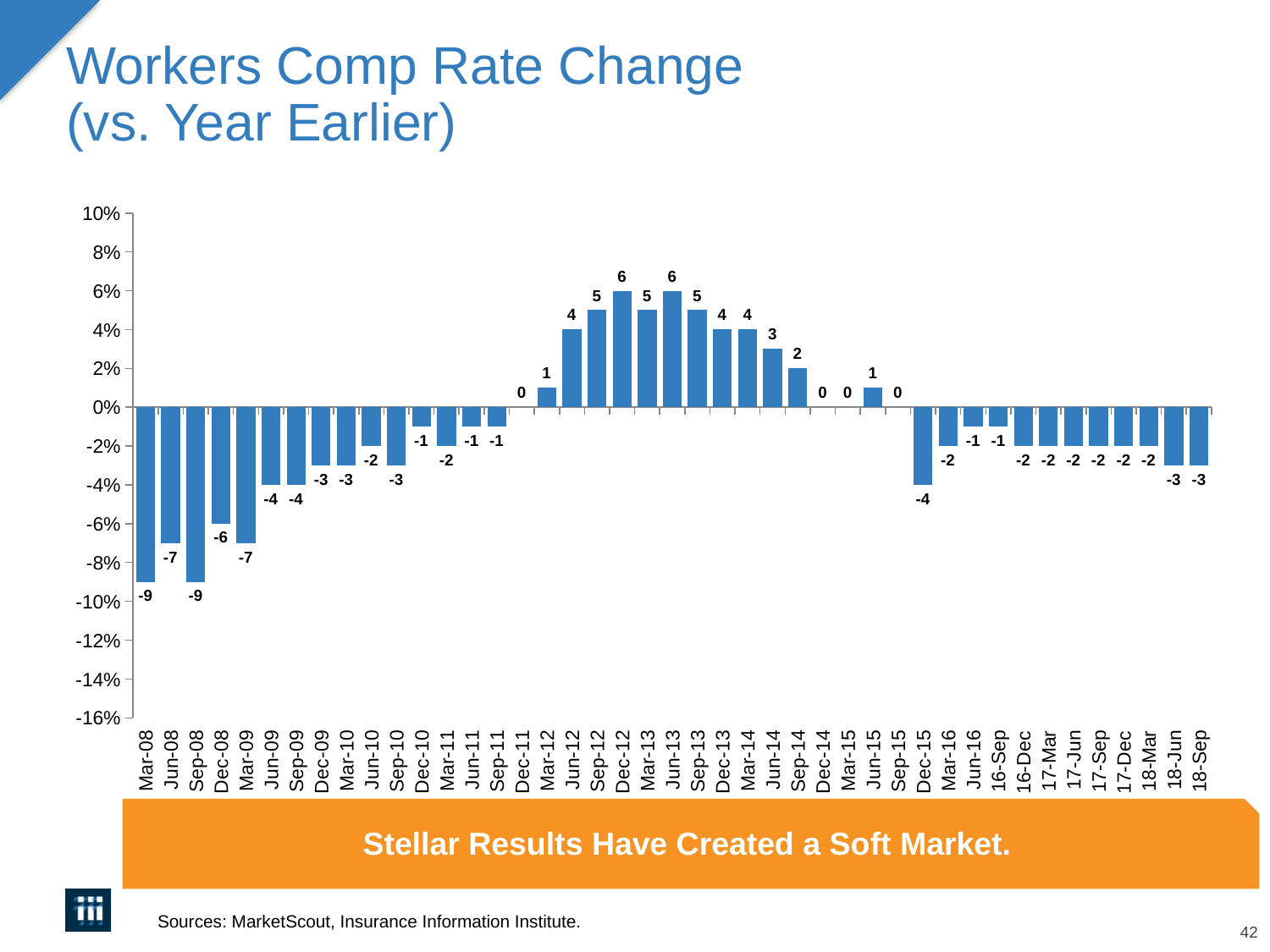
What is the value for Dec-12? 6 Which is larger, the value for Jun-12 or the value for Jun-14? Jun-12 What is the value for 18-Sep? -3 What is the difference between the values for Dec-12 and Sep-14? 4 What is the value for Mar-08? -9 What is the value for Dec-15? -4 What is the lowest value shown on the chart? -9 What is the highest value shown on the chart? 6 How many periods are shown on the x axis? 43 What kind of chart is shown on the slide? Bar chart Is the value for Sep-08 greater or less than -8%? less Do the values rise or fall from Mar-08 to Dec-12? Rise